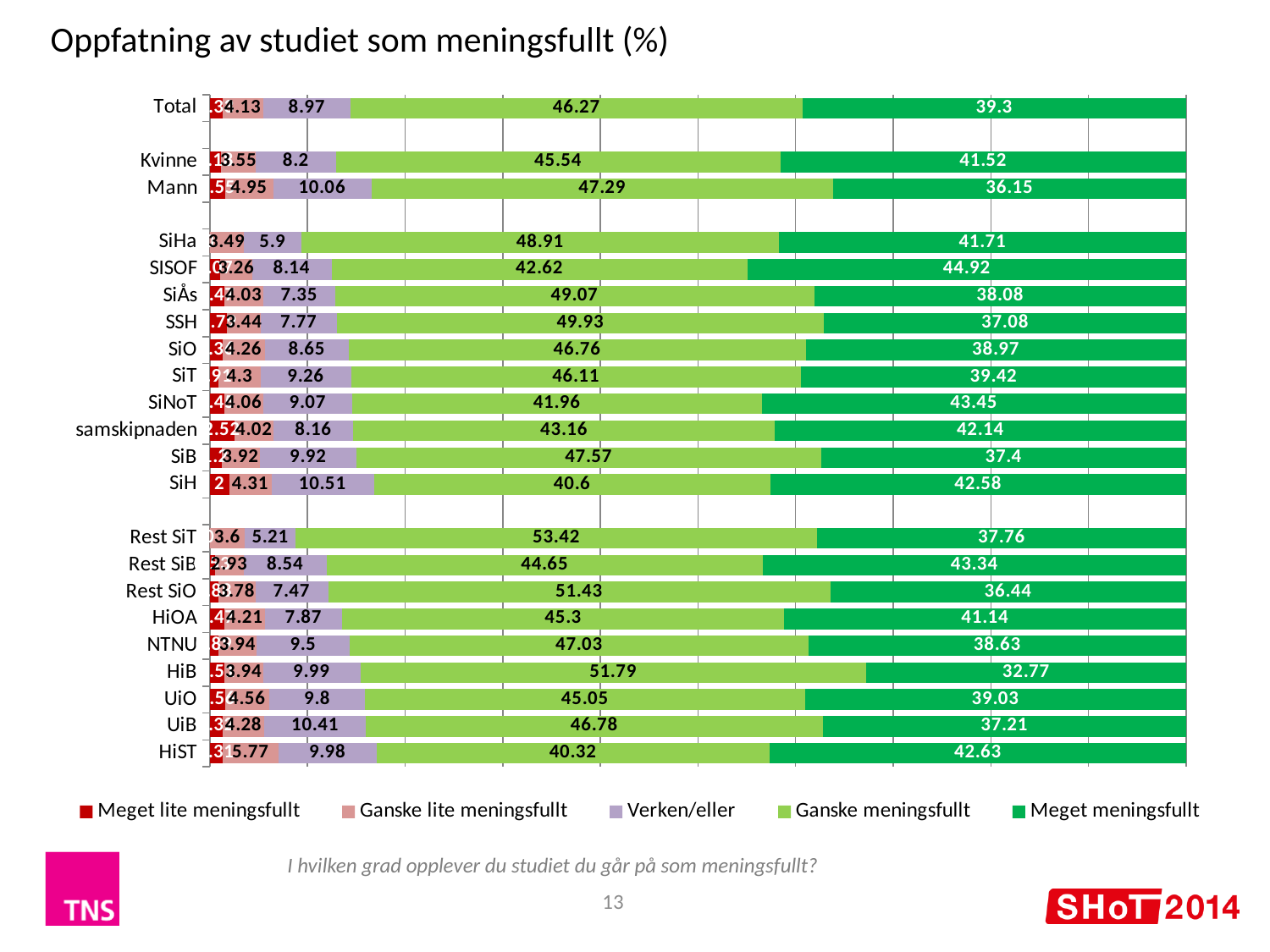
What is the difference between the "Meget meningsfullt" values for Kvinne and Mann? 5.37 Which category has the lowest value for "Meget meningsfullt"? HiB What kind of chart is shown? Stacked bar chart What is the value for "Verken/eller" for SiH? 10.51 Which category has the highest value for "Meget meningsfullt"? SISOF What is the value for "Ganske lite meningsfullt" for HiST? 5.77 How many categories are shown on the y axis? 22 What is the value for "Meget meningsfullt" for Total? 39.3 What is the value for "Ganske meningsfullt" for Mann? 47.29 Which category has the highest value for "Ganske meningsfullt"? Rest SiT Which has a larger "Ganske meningsfullt" value, SiÅs or SiNoT? SiÅs How many series does the legend list? 5